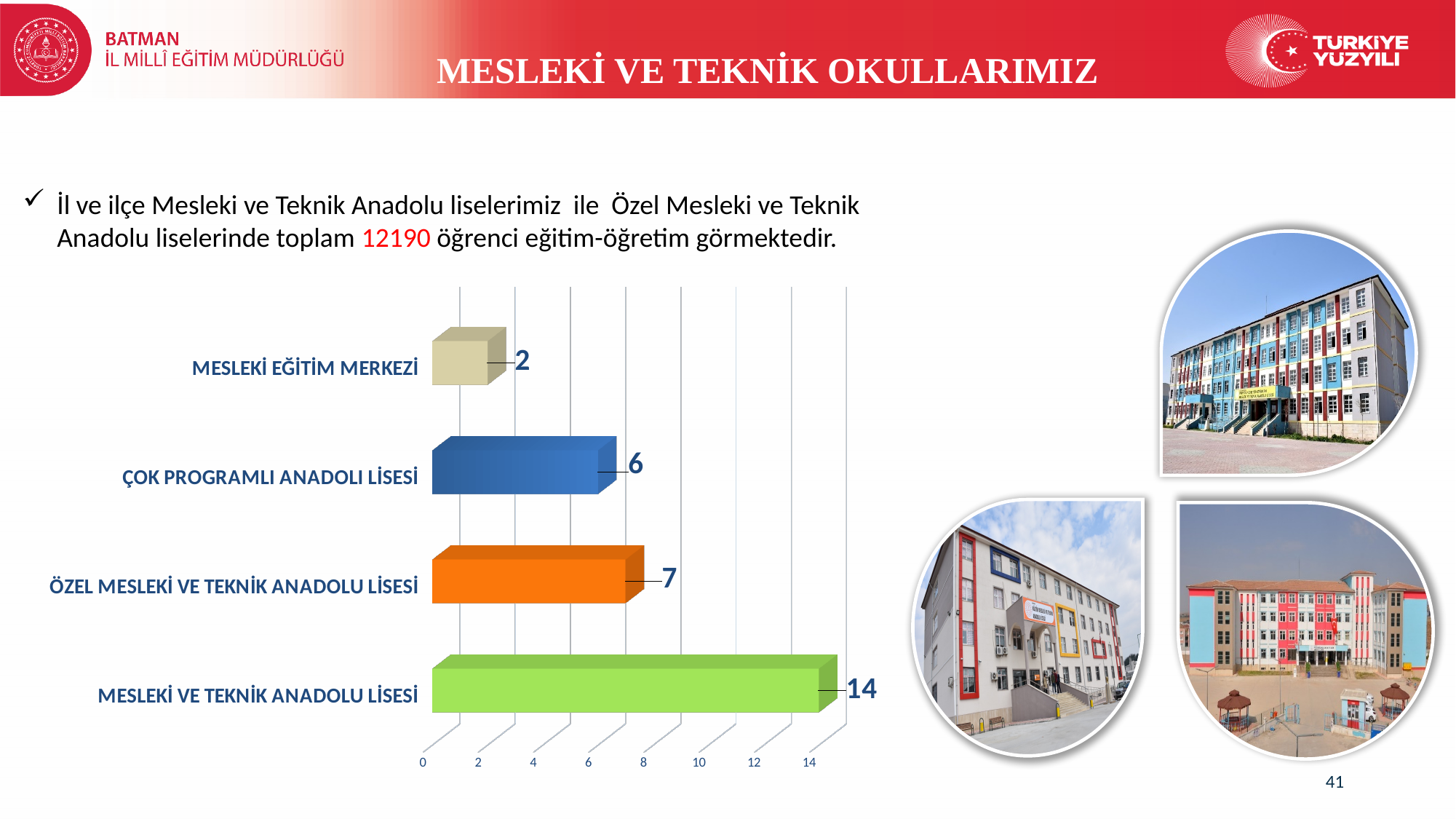
What is the value for MESLEKİ VE TEKNİK ANADOLU LİSESİ? 14 Which category has the highest value? MESLEKİ VE TEKNİK ANADOLU LİSESİ Is the value for ÇOK PROGRAMLI ANADOLU LİSESİ greater or less than 10? less Which category has the lowest value? MESLEKİ EĞİTİM MERKEZİ What is the difference between the values for MESLEKİ VE TEKNİK ANADOLU LİSESİ and ÖZEL MESLEKİ VE TEKNİK ANADOLU LİSESİ? 7 What is the highest tick value shown on the value axis of the chart? 14 How many categories are shown in the chart? 4 What is the value for ÇOK PROGRAMLI ANADOLU LİSESİ? 6 What is the value for ÖZEL MESLEKİ VE TEKNİK ANADOLU LİSESİ? 7 What kind of chart is shown on the slide? bar chart Which is larger: the value for ÖZEL MESLEKİ VE TEKNİK ANADOLU LİSESİ or the value for ÇOK PROGRAMLI ANADOLU LİSESİ? ÖZEL MESLEKİ VE TEKNİK ANADOLU LİSESİ What is the value for MESLEKİ EĞİTİM MERKEZİ? 2